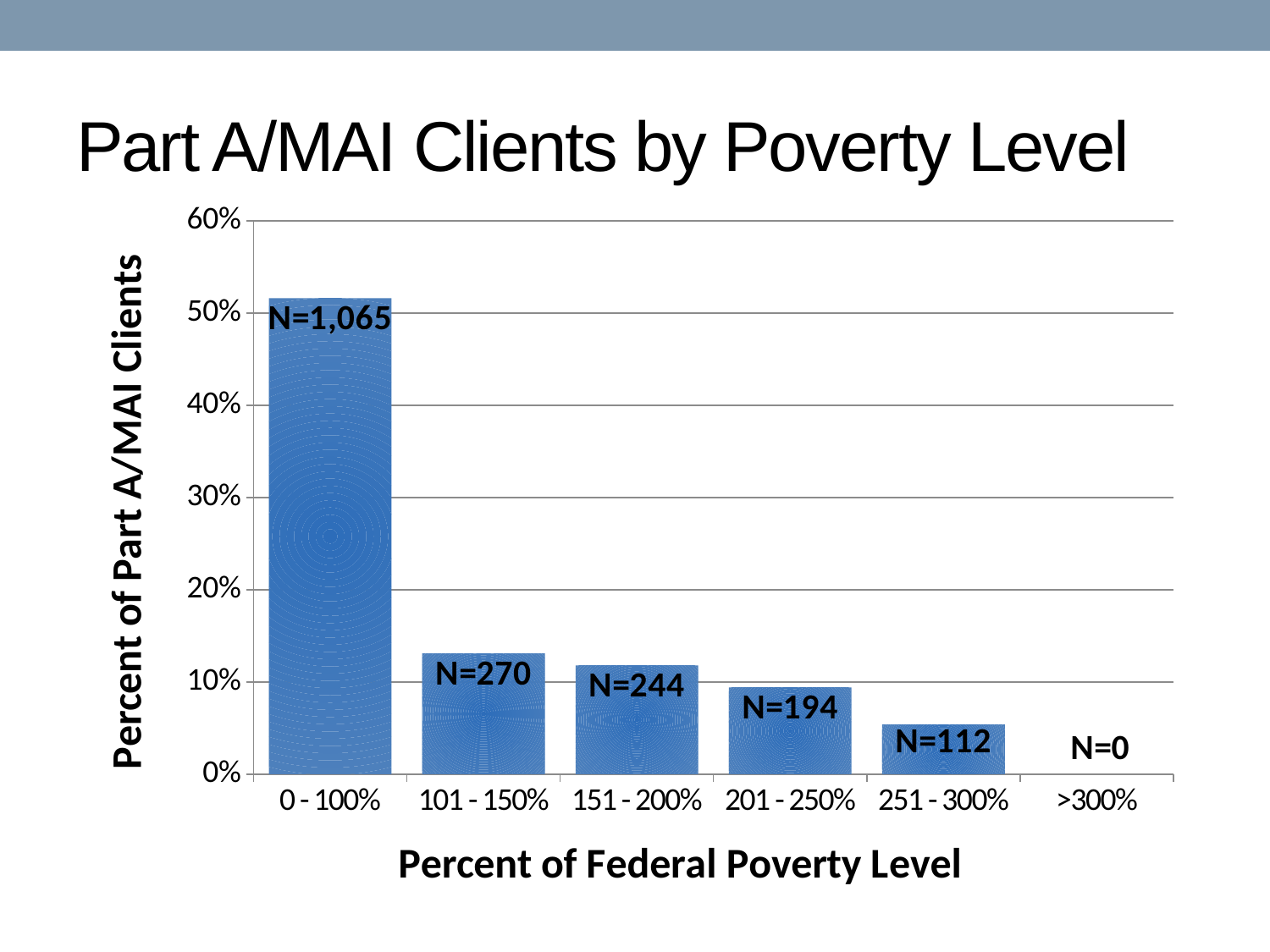
What is the N label shown for the >300% poverty level category? N=0 Is the percent of Part A/MAI clients in the 201 - 250% category greater or less than 10%? less What kind of chart is shown on the slide? bar chart Which poverty level category has the highest percent of Part A/MAI clients? 0 - 100% How many poverty level categories are shown on the x axis? 6 Is the percent of Part A/MAI clients in the 0 - 100% category greater or less than 50%? greater Which poverty level category has the lowest percent of Part A/MAI clients? >300% What is the N label on the bar for the 251 - 300% poverty level category? N=112 What is the N label on the bar for the 0 - 100% poverty level category? N=1,065 Which category has more clients, 151 - 200% or 201 - 250%? 151 - 200% What is the N label on the bar for the 101 - 150% poverty level category? N=270 What is the label of the x axis? Percent of Federal Poverty Level